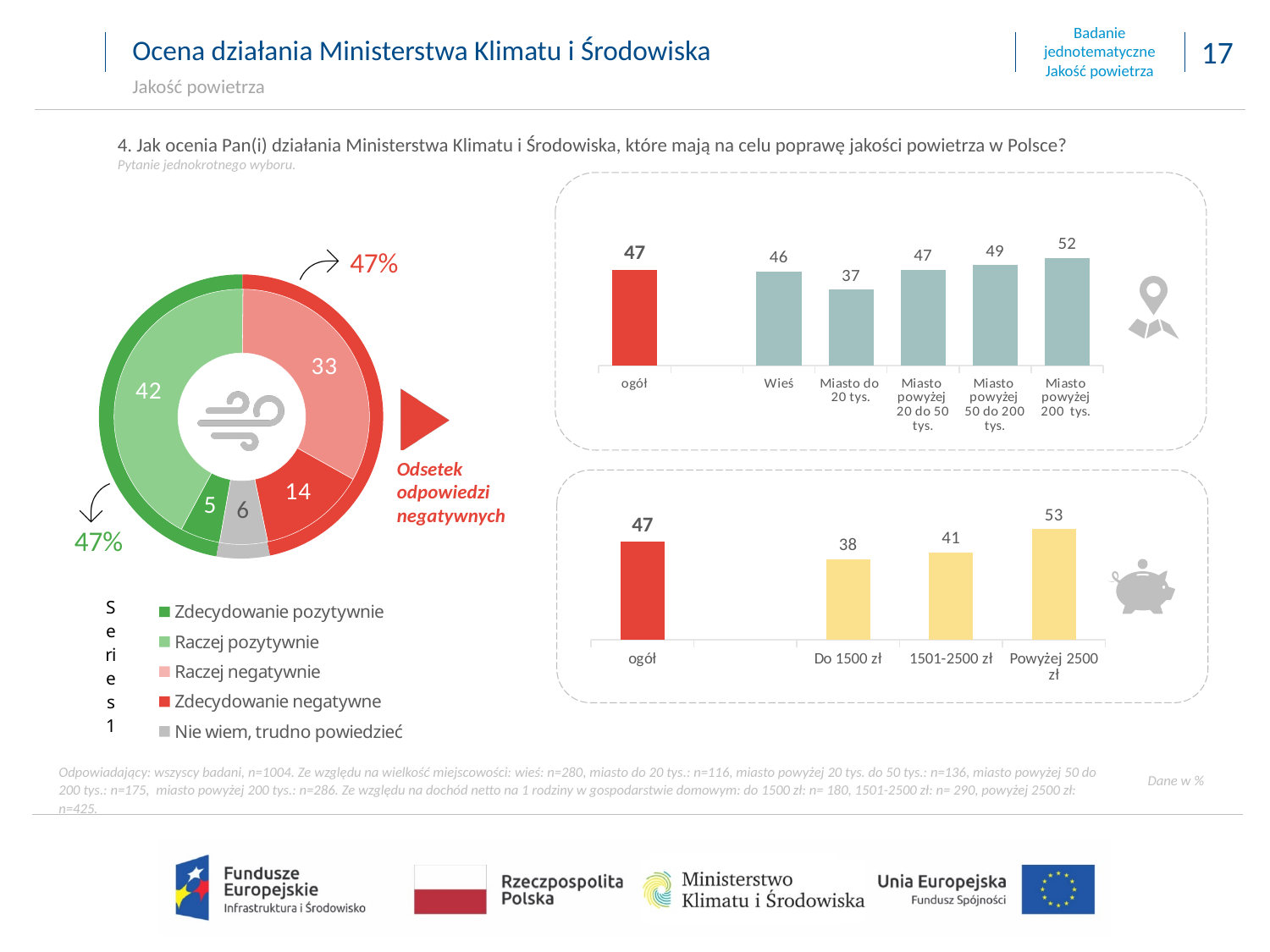
In the top-right bar chart, which category has the highest value? Miasto powyżej 200 tys. In the bottom-right bar chart, what is the value for '1501-2500 zł'? 41 In the donut chart on the left, which category has the lowest value? Zdecydowanie pozytywnie What type of chart is the bottom-right chart? bar chart How many entries does the legend of the donut chart on the left list? 5 In the donut chart on the left, what value is shown for 'Zdecydowanie negatywne'? 14 In the top-right bar chart, what is the difference between 'Miasto powyżej 200 tys.' and 'Miasto do 20 tys.'? 15 In the bottom-right bar chart, which is larger: 'Do 1500 zł' or 'Powyżej 2500 zł'? Powyżej 2500 zł In the bottom-right bar chart, do the values rise or fall from 'Do 1500 zł' to 'Powyżej 2500 zł'? rise In the donut chart on the left, what value is shown for 'Raczej pozytywnie'? 42 How many bars are shown in the top-right bar chart? 6 In the top-right bar chart, what is the value for 'Miasto do 20 tys.'? 37